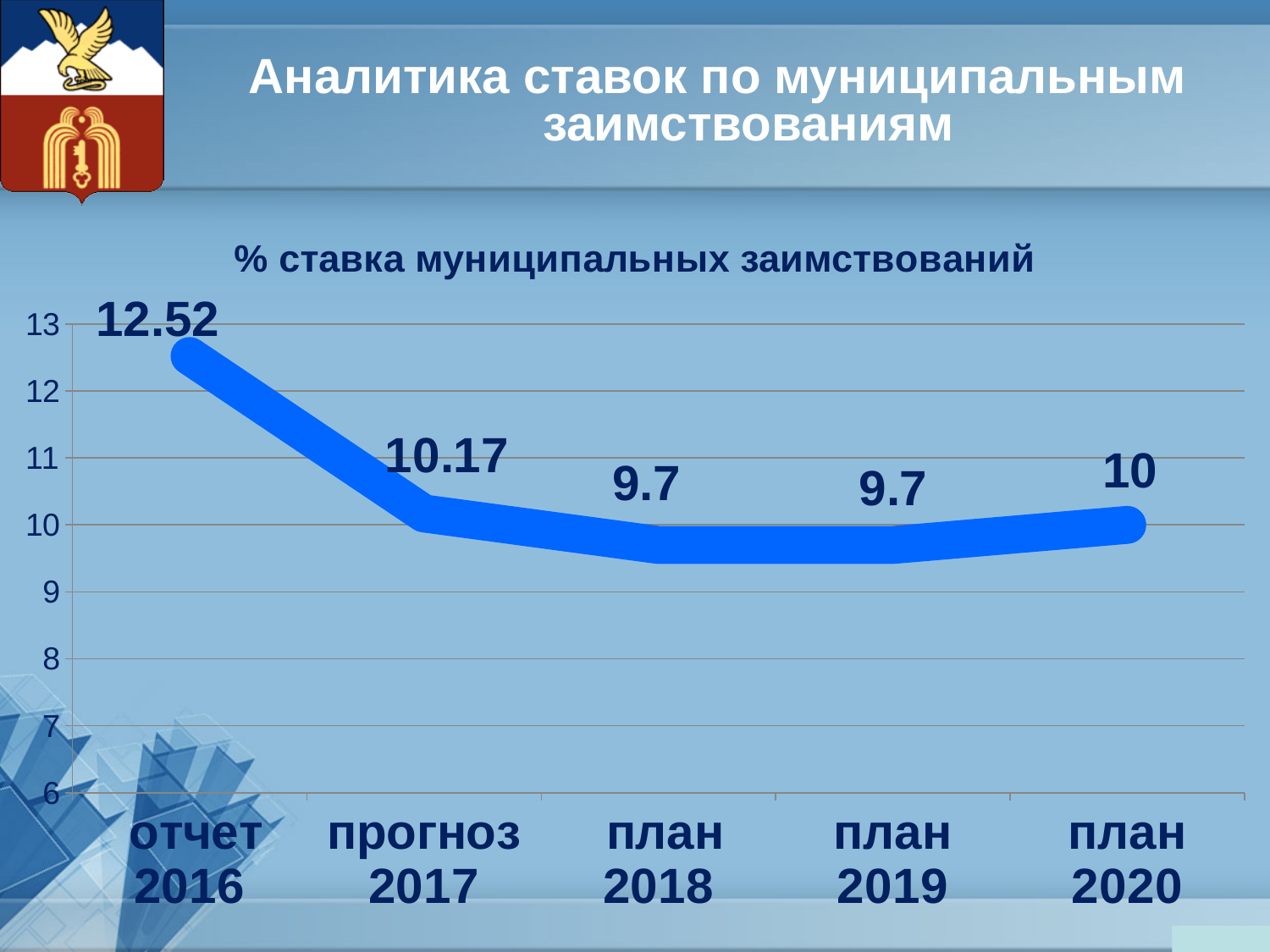
What kind of chart is shown on the slide? line chart Is the value for план 2018 greater or less than 10? less What is the value for прогноз 2017? 10.17 Which category has the highest value? отчет 2016 What is the title of the chart? % ставка муниципальных заимствований What is the value for план 2020? 10 What is the difference between the values for план 2020 and план 2019? 0.3 What is the difference between the values for отчет 2016 and прогноз 2017? 2.35 How many categories are shown on the x axis? 5 What is the lowest value shown on the chart? 9.7 What is the value for отчет 2016? 12.52 Which is larger, the value for прогноз 2017 or the value for план 2018? прогноз 2017